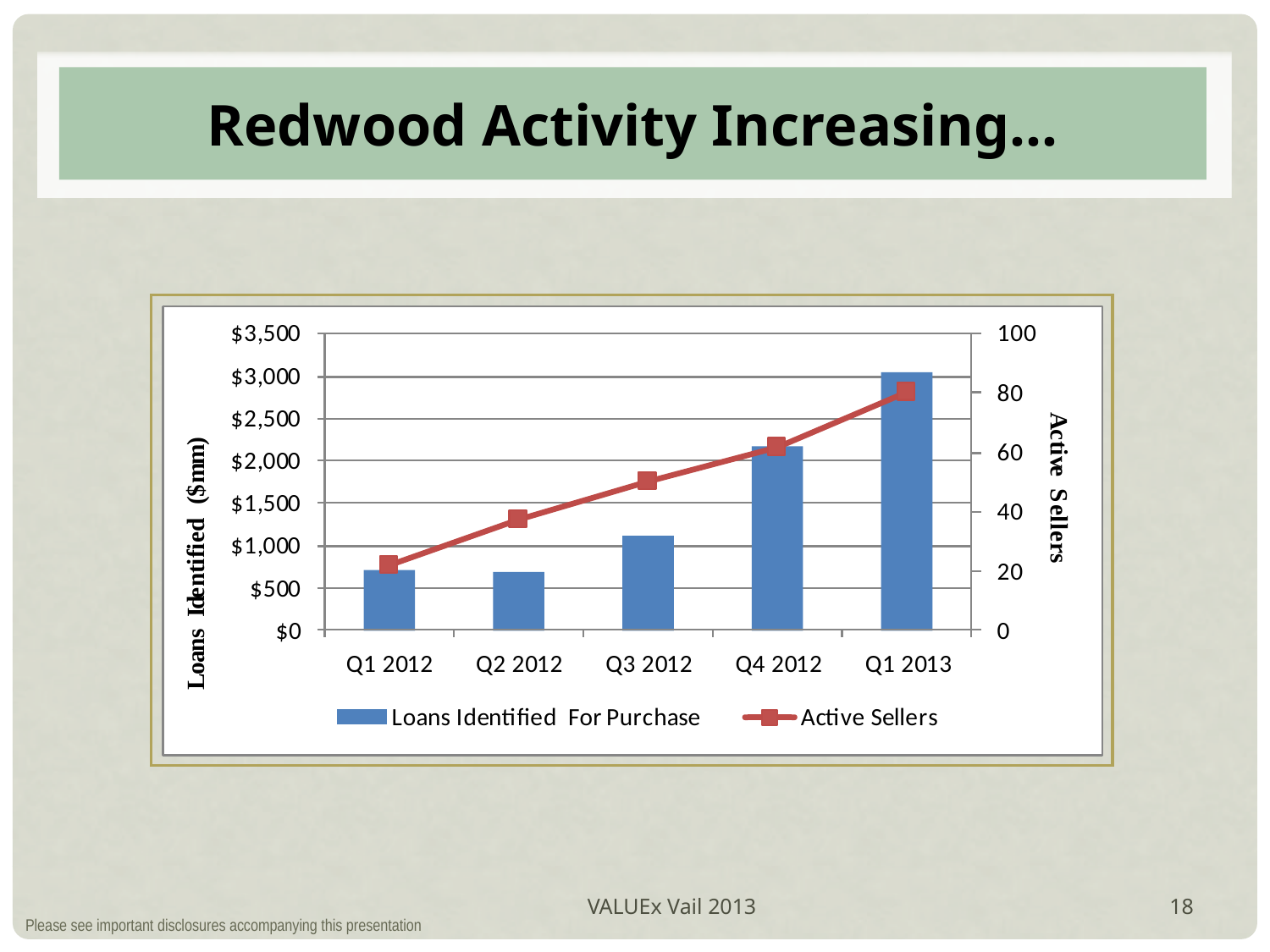
How many quarters are shown on the x axis of the chart? 5 What colour are the Loans Identified For Purchase bars? Blue Do the Active Sellers values rise or fall from Q1 2012 to Q1 2013? rise Which is larger: Loans Identified For Purchase in Q4 2012 or in Q3 2012? Q4 2012 What is the title of the right-hand vertical axis? Active Sellers Which quarter has the highest value for Loans Identified For Purchase? Q1 2013 Which quarter has the lowest number of Active Sellers? Q1 2012 How many series does the chart's legend list? 2 Is the value for Loans Identified For Purchase in Q3 2012 greater or less than $1,000? greater